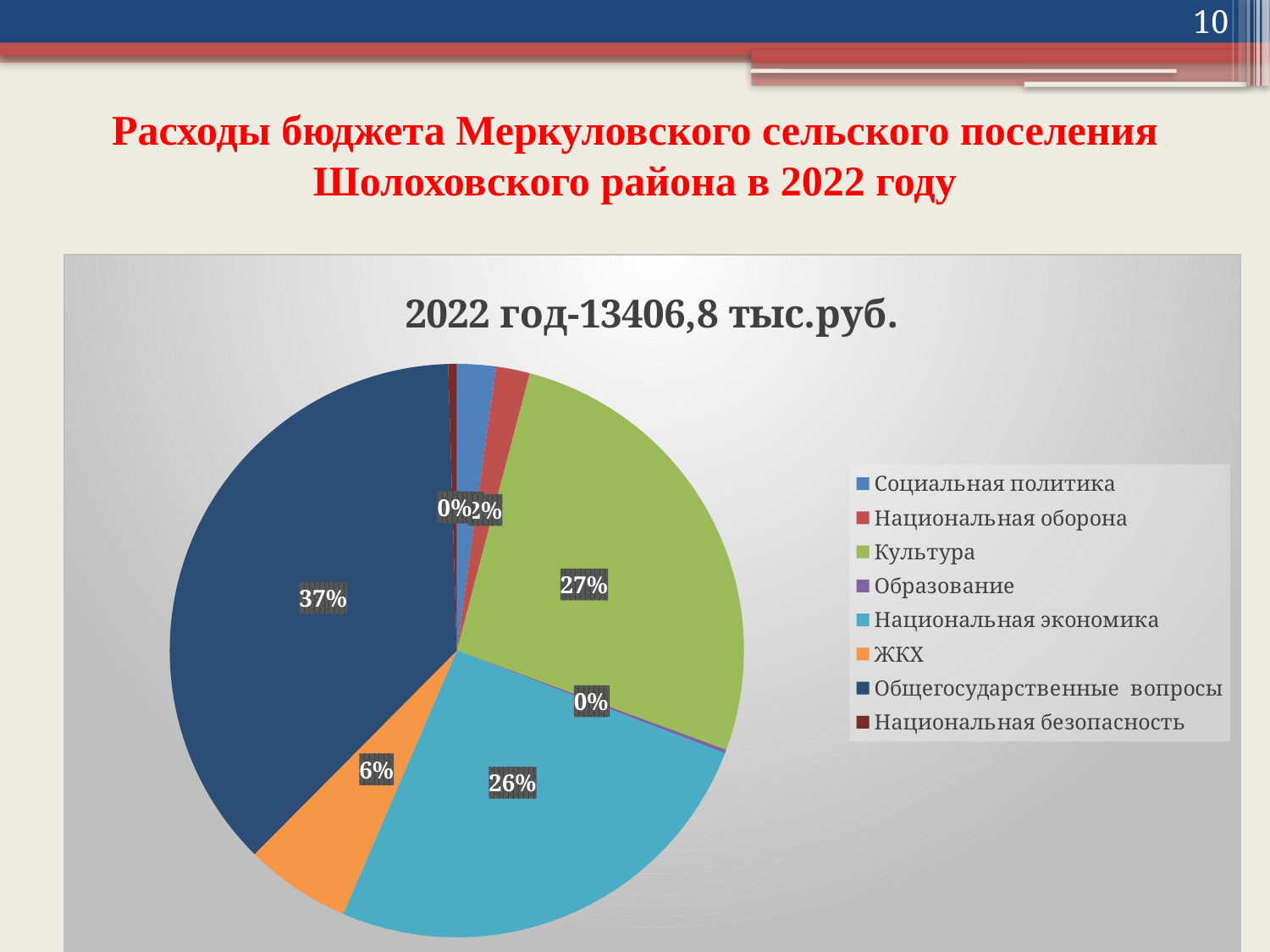
What is the difference in percentage points between Общегосударственные вопросы and Культура? 10 How many categories does the chart legend list? 8 Which is larger, the share for Культура or the share for Национальная экономика? Культура What share of the pie does ЖКХ take? 6% What kind of chart is shown on the slide? pie chart What share of the pie does Общегосударственные вопросы take? 37% What is the difference in percentage points between Национальная экономика and ЖКХ? 20 What share of the pie does Культура take? 27% What colour is the slice for Культура? green Which category has the largest slice of the pie? Общегосударственные вопросы What is the title of the chart? 2022 год-13406,8 тыс.руб.